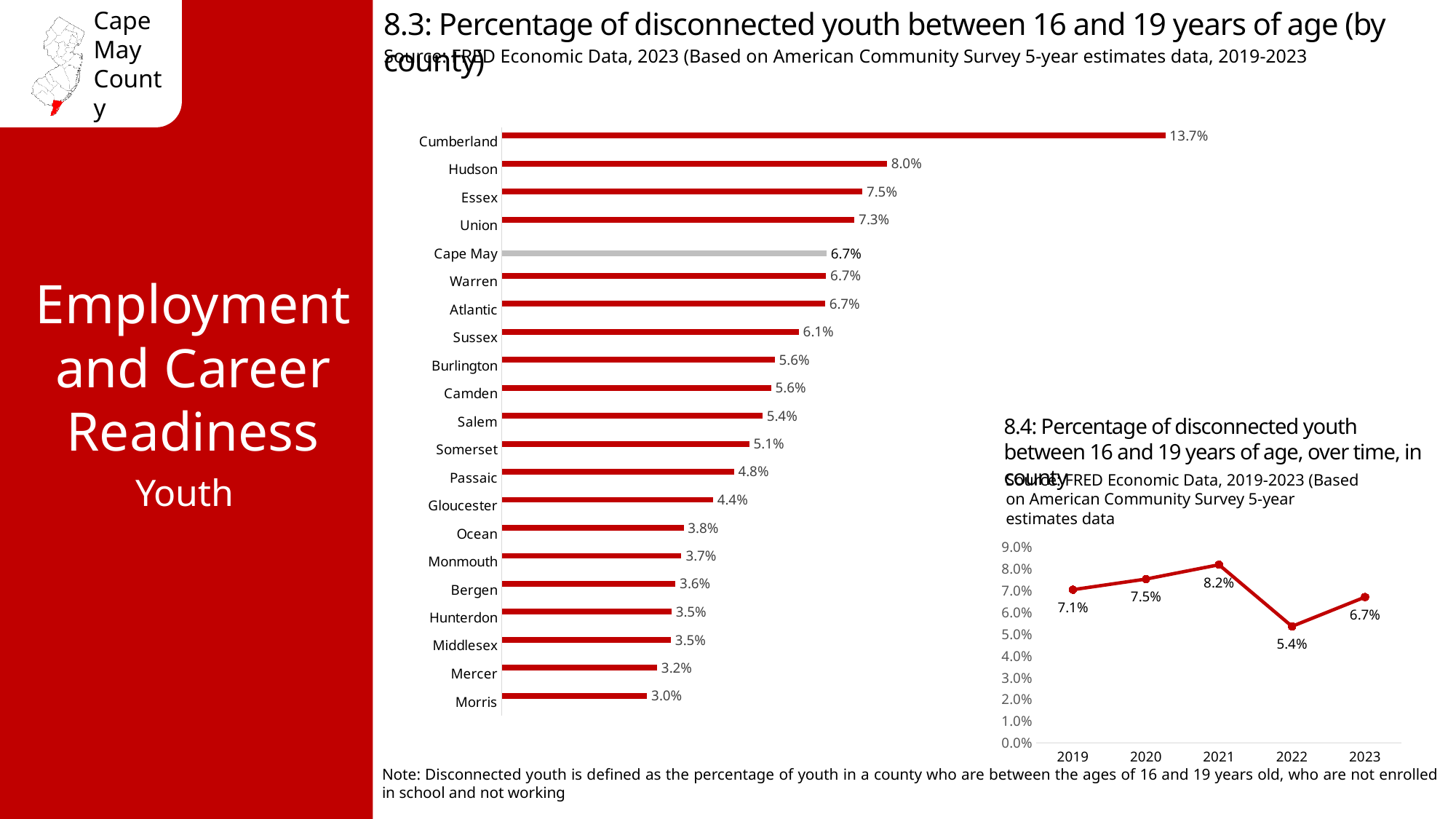
In the line chart 8.4 (over time), how many data points are plotted? 5 In the line chart 8.4 (over time), what is the difference between the 2021 and 2022 values? 2.8% In the bar chart 8.3 (by county), which county's bar is shown in grey instead of red? Cape May In the bar chart 8.3 (by county), what is the difference between Cumberland and Hudson? 5.7% In the bar chart 8.3 (by county), which is larger, the value for Essex or the value for Sussex? Essex In the line chart 8.4 (over time), what is the value for 2021? 8.2% In the bar chart 8.3 (by county), which county has the lowest percentage of disconnected youth? Morris In the bar chart 8.3 (by county), what is the value for Cape May? 6.7% In the bar chart 8.3 (by county), which county has the highest percentage of disconnected youth? Cumberland What kind of chart is chart 8.3 (by county)? Bar chart In the bar chart 8.3 (by county), how many counties are shown? 21 In the line chart 8.4 (over time), which year has the lowest value? 2022